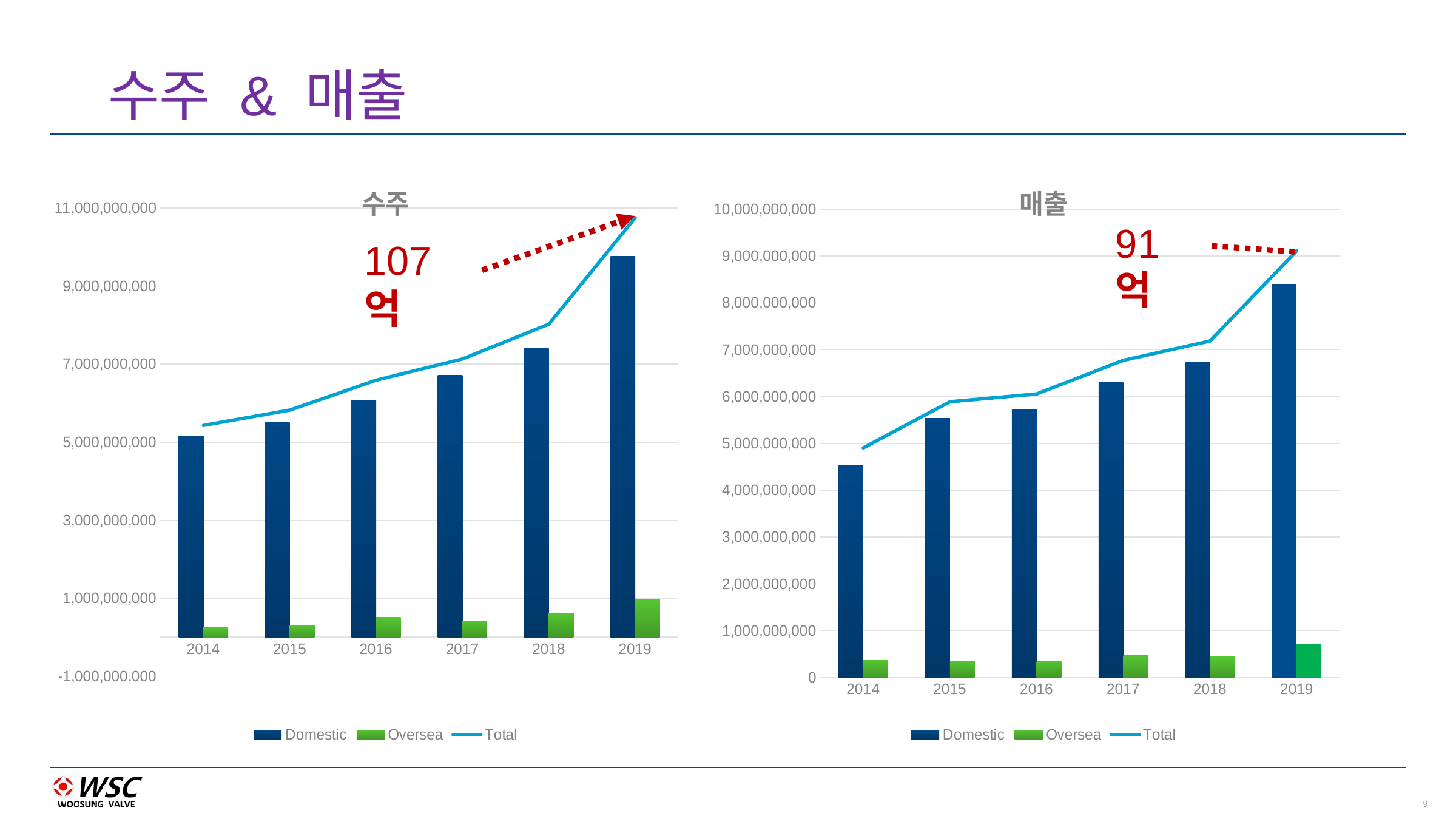
In the 매출 chart, which year has the highest Oversea bar? 2019 In the 수주 chart, is the Domestic value for 2019 greater or less than 9,000,000,000? greater How many years are shown on the x axis of the 매출 chart on the right? 6 In the 매출 chart, which year has the lowest Domestic bar? 2014 How many series does the legend of the 수주 chart list? 3 In the 매출 chart, is the Domestic value for 2019 greater or less than 8,000,000,000? greater What kind of chart is the 수주 chart on the left? Combined bar and line chart In the 매출 chart, does the Total line rise or fall from 2014 to 2019? rises In the 수주 chart, which year has the highest Domestic bar? 2019 In the 매출 chart, is the Domestic value for 2014 greater or less than 5,000,000,000? less In the 수주 chart, which is larger: the Domestic value for 2018 or for 2017? 2018 What value is annotated in red next to the 2019 peak of the 수주 chart? 107억